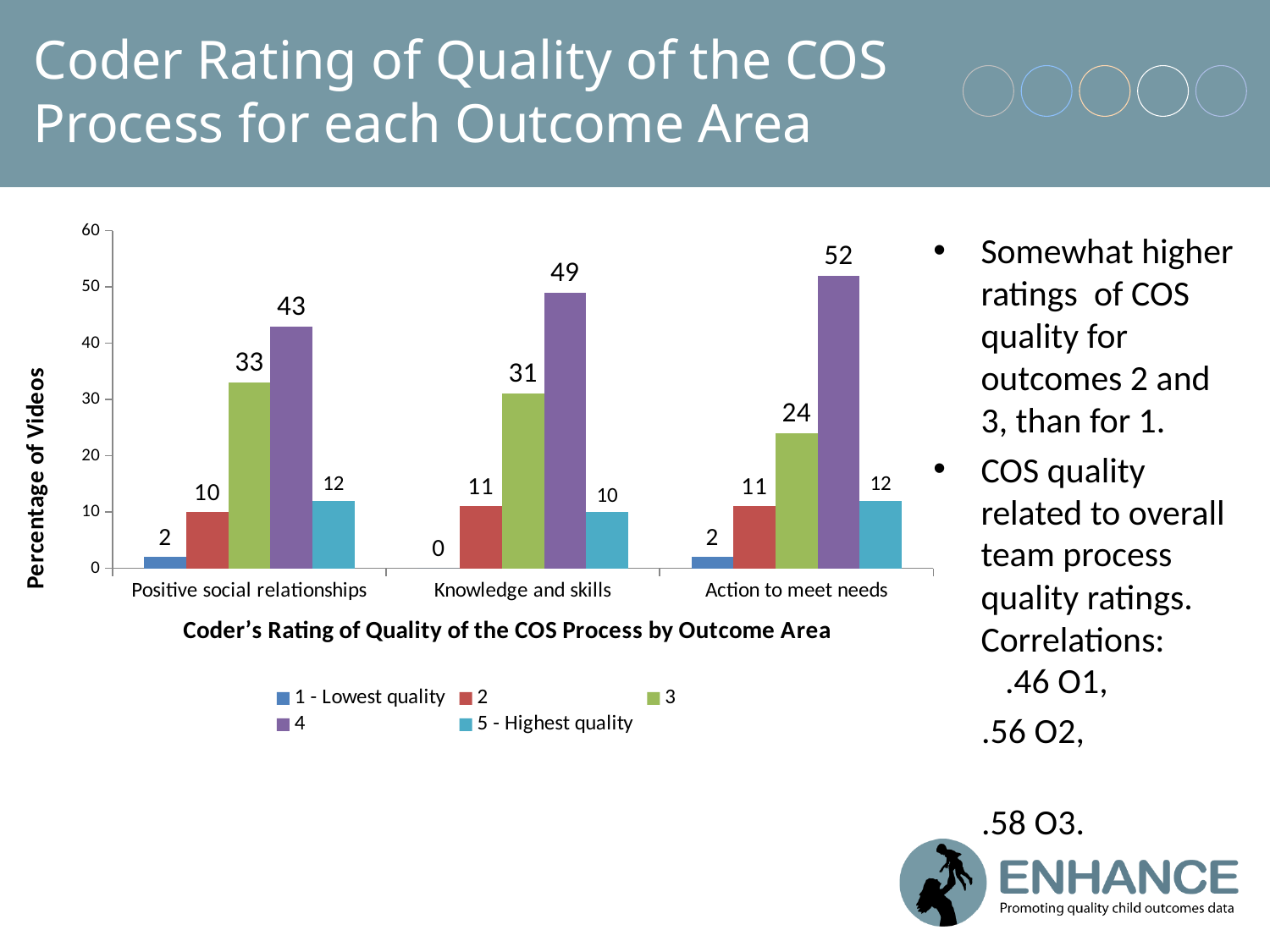
Which is larger: the rating 3 value for Positive social relationships or for Knowledge and skills? Positive social relationships What is the difference between the rating 4 values for Action to meet needs and Positive social relationships? 9 What kind of chart is shown on the slide? Bar chart What is the value for 5 - Highest quality in the Action to meet needs category? 12 Which category has the highest value for rating 4? Action to meet needs Which category has the lowest value for rating 3? Action to meet needs What is the value for 1 - Lowest quality in the Knowledge and skills category? 0 How many series does the legend list? 5 What is the label of the y axis? Percentage of Videos How many outcome area categories are shown on the x axis? 3 What is the value for rating 4 in the Knowledge and skills category? 49 What is the value for rating 3 in the Positive social relationships category? 33